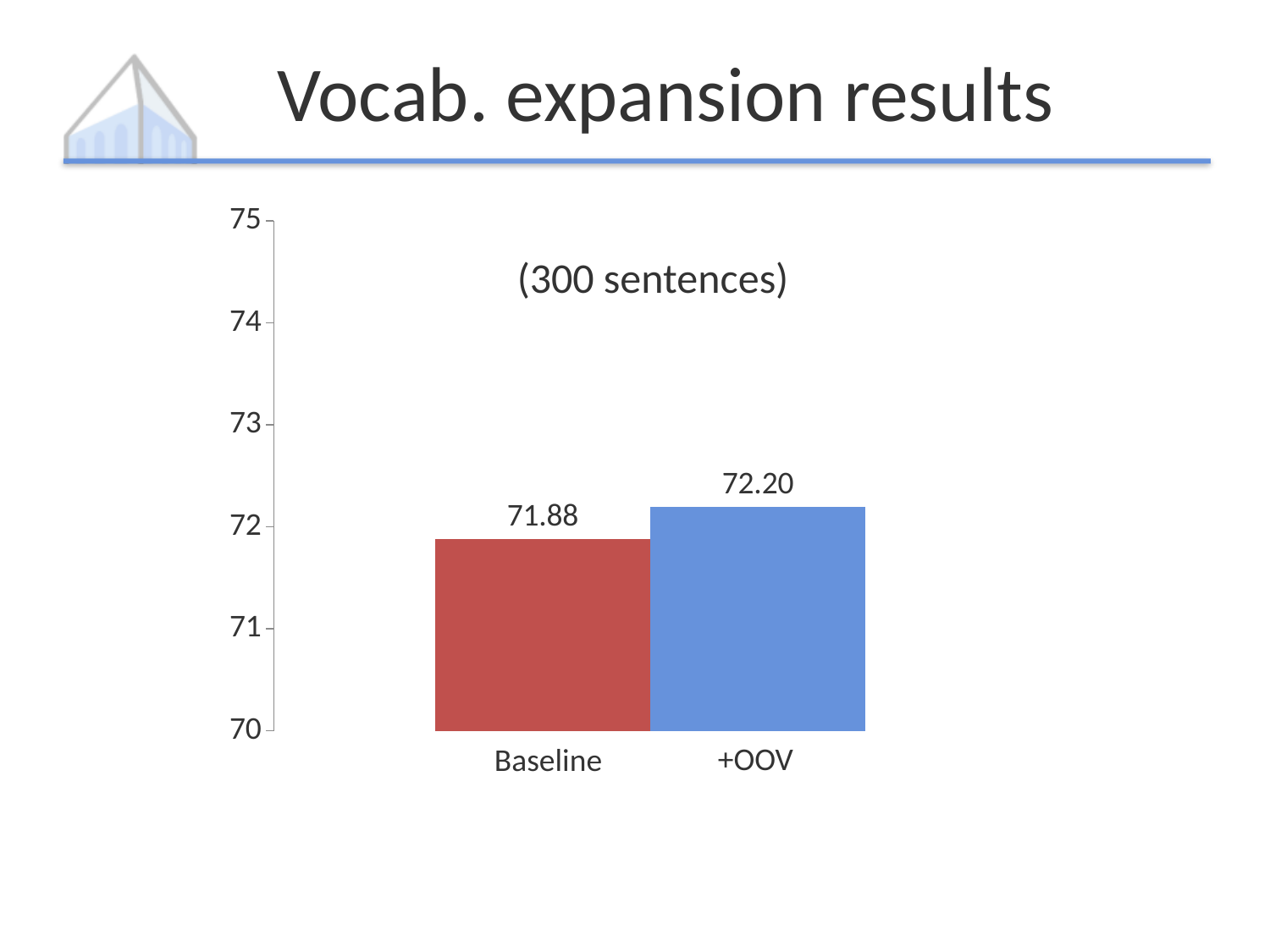
How many categories are shown in the chart? 2 Which is larger, the value for Baseline or the value for +OOV? +OOV What is the difference between the +OOV and Baseline values? 0.32 Is the value for +OOV greater or less than 72? greater What is the value for +OOV? 72.20 Which category has the lowest value? Baseline What text is shown inside the chart area above the bars? (300 sentences) Is the value for Baseline greater or less than 72? less What kind of chart is shown on the slide? bar chart Which category has the highest value? +OOV What is the value for Baseline? 71.88 What is the title of the slide? Vocab. expansion results